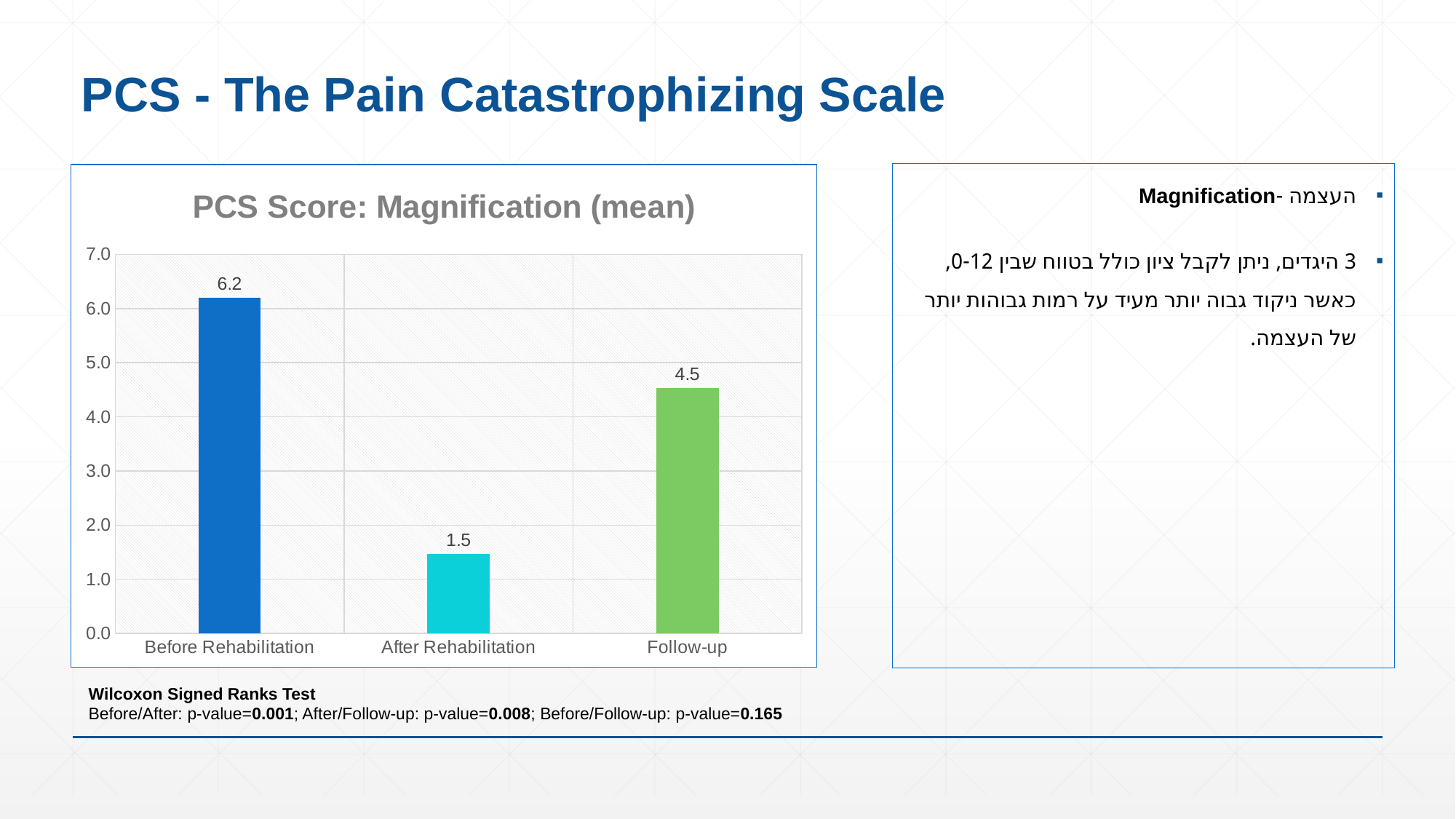
What is the mean PCS Magnification score Before Rehabilitation? 6.2 Which is larger, the Before Rehabilitation score or the Follow-up score? Before Rehabilitation What is the mean PCS Magnification score After Rehabilitation? 1.5 What is the title of the chart? PCS Score: Magnification (mean) Is the value for Follow-up greater or less than 4.0? greater What is the mean PCS Magnification score at Follow-up? 4.5 What is the difference between the Follow-up and After Rehabilitation mean scores? 3.0 Which time point has the highest mean PCS Magnification score? Before Rehabilitation Which time point has the lowest mean PCS Magnification score? After Rehabilitation What kind of chart is shown on the slide? Bar chart How many time points (categories) are shown in the chart? 3 What is the difference between the Before Rehabilitation and After Rehabilitation mean scores? 4.7